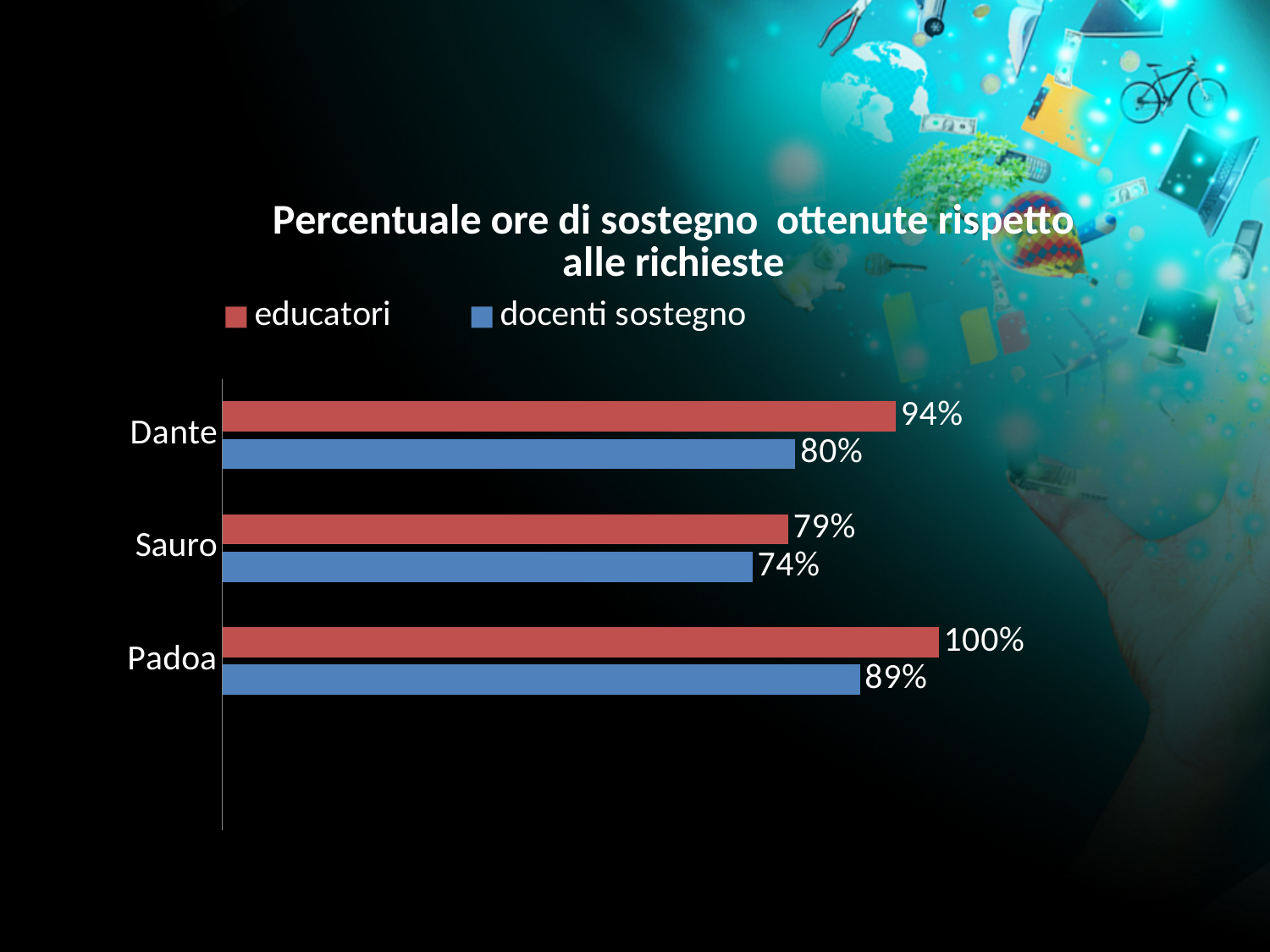
What is the title of the chart? Percentuale ore di sostegno ottenute rispetto alle richieste What kind of chart is shown on the slide? bar chart Which category has the highest educatori value? Padoa What is the educatori value for Padoa? 100% How many series does the legend list? 2 What is the educatori value for Dante? 94% What is the docenti sostegno value for Sauro? 74% Which is larger for Sauro: educatori or docenti sostegno? educatori What is the difference between the educatori and docenti sostegno values for Dante? 14% How many categories are shown on the chart? 3 What is the docenti sostegno value for Padoa? 89% Which category has the lowest docenti sostegno value? Sauro